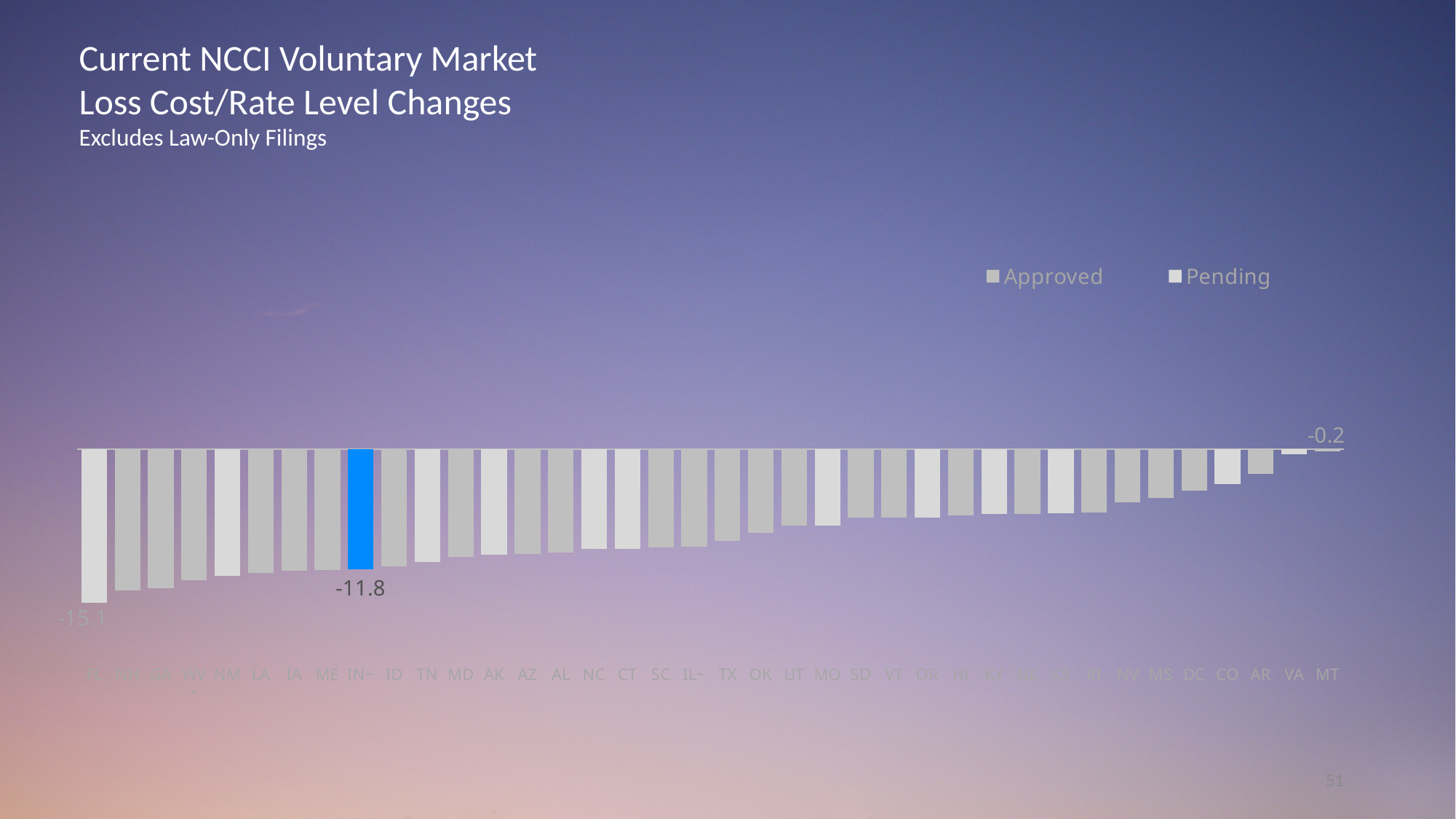
What is the value labelled on the leftmost bar of the chart? -15.1 Which category has the highest (least negative) value? MT What kind of chart is shown on the slide? bar chart Do the values rise or fall moving from left to right along the x axis? rise What are the two series named in the legend? Approved and Pending What is the difference between the values for IN~ and MT? 11.6 What is the difference between the leftmost bar's value (-15.1) and the value for IN~? 3.3 Which has the larger value, IN~ or MT? MT What is the value shown for IN~? -11.8 How many series does the legend list? 2 What is the value shown for MT? -0.2 What is the lowest value labelled on the chart? -15.1